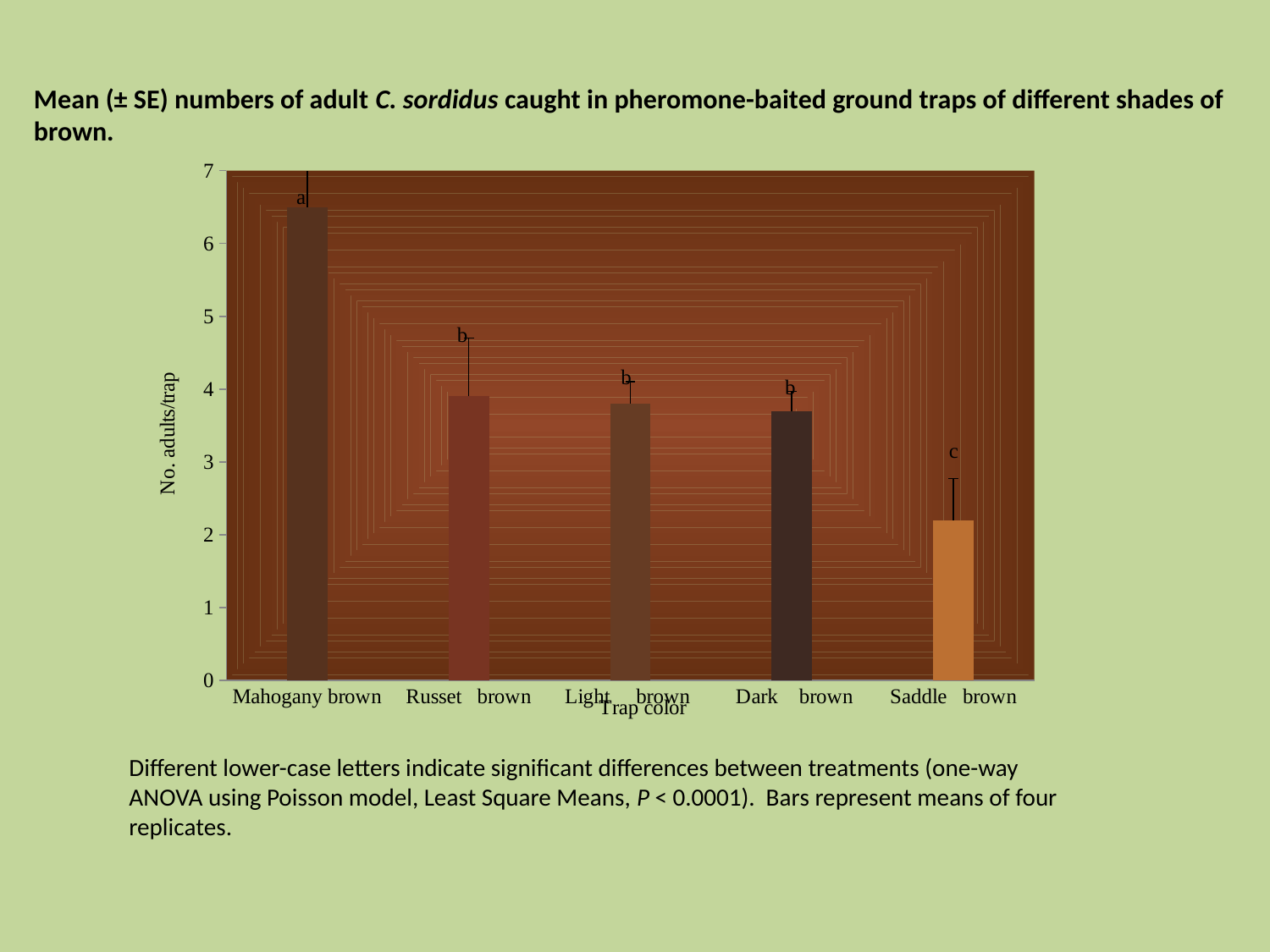
How many trap colors are plotted on the x axis? 5 What is the title of the y axis? No. adults/trap Which trap color has the highest mean number of adults per trap? Mahogany brown Which trap color has the lowest mean number of adults per trap? Saddle brown Is the value for Saddle brown greater or less than 3? less What kind of chart is shown on the slide? bar chart Which has a larger value, Mahogany brown or Russet brown? Mahogany brown Which has a larger value, Dark brown or Saddle brown? Dark brown Is the value for Saddle brown greater or less than 2? greater Is the value for Mahogany brown greater or less than 6? greater Which significance letter is shown above the Saddle brown bar? c